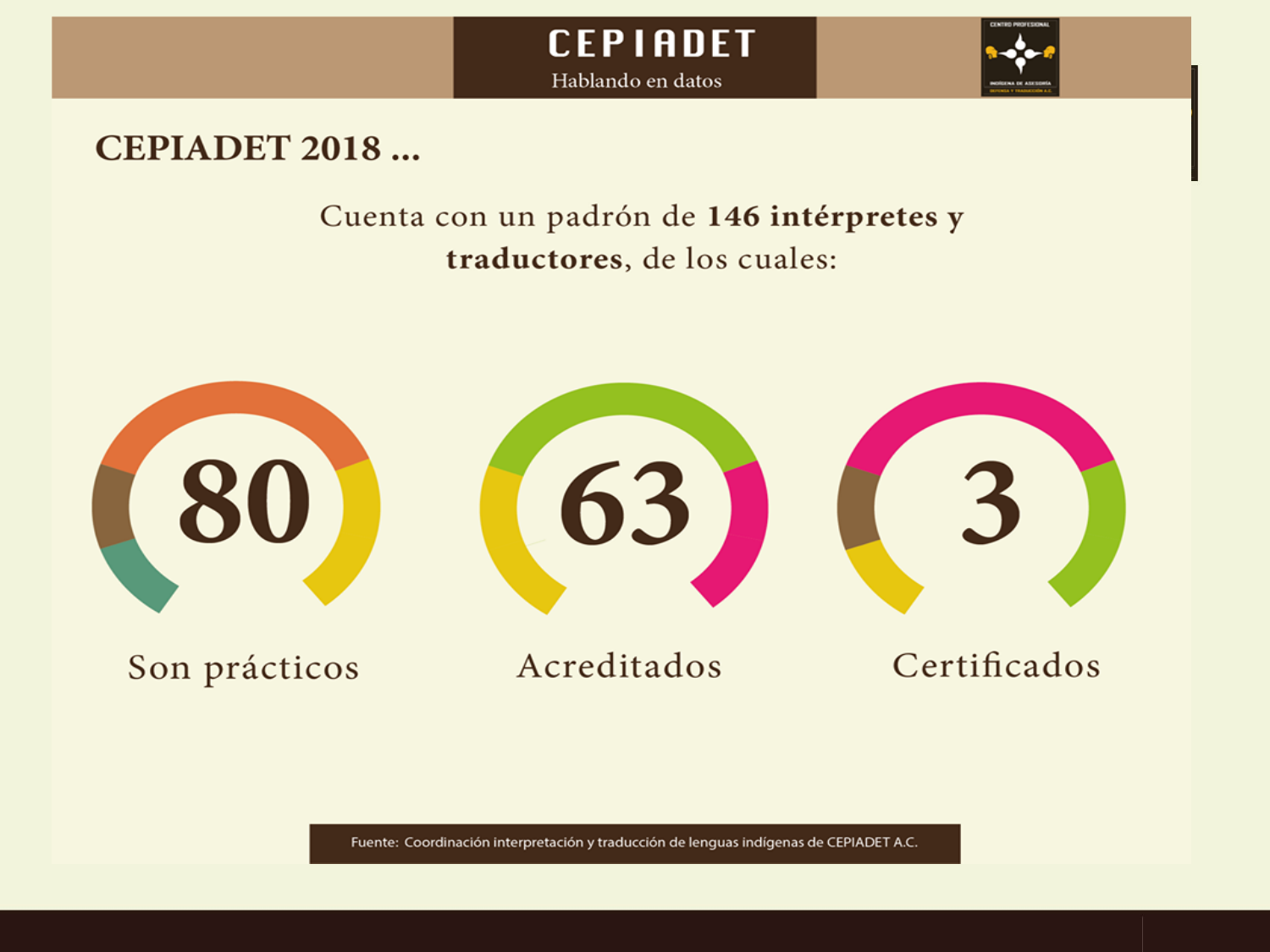
What is the difference between the values for 'Acreditados' and 'Certificados'? 60 What is the value shown for 'Certificados'? 3 Which of the three categories has the highest value? Son prácticos What year does the slide title refer to? 2018 What is the difference between the values for 'Son prácticos' and 'Acreditados'? 17 What is the total number of interpreters and translators in the registry stated on the slide? 146 Which is larger, the value for 'Acreditados' or the value for 'Certificados'? Acreditados How many categories are shown with gauge graphics on the slide? 3 What is the value shown for 'Acreditados'? 63 How many interpreters and translators are 'Son prácticos' according to the slide? 80 What is the subtitle shown under 'CEPIADET' in the header? Hablando en datos Which of the three categories has the lowest value? Certificados